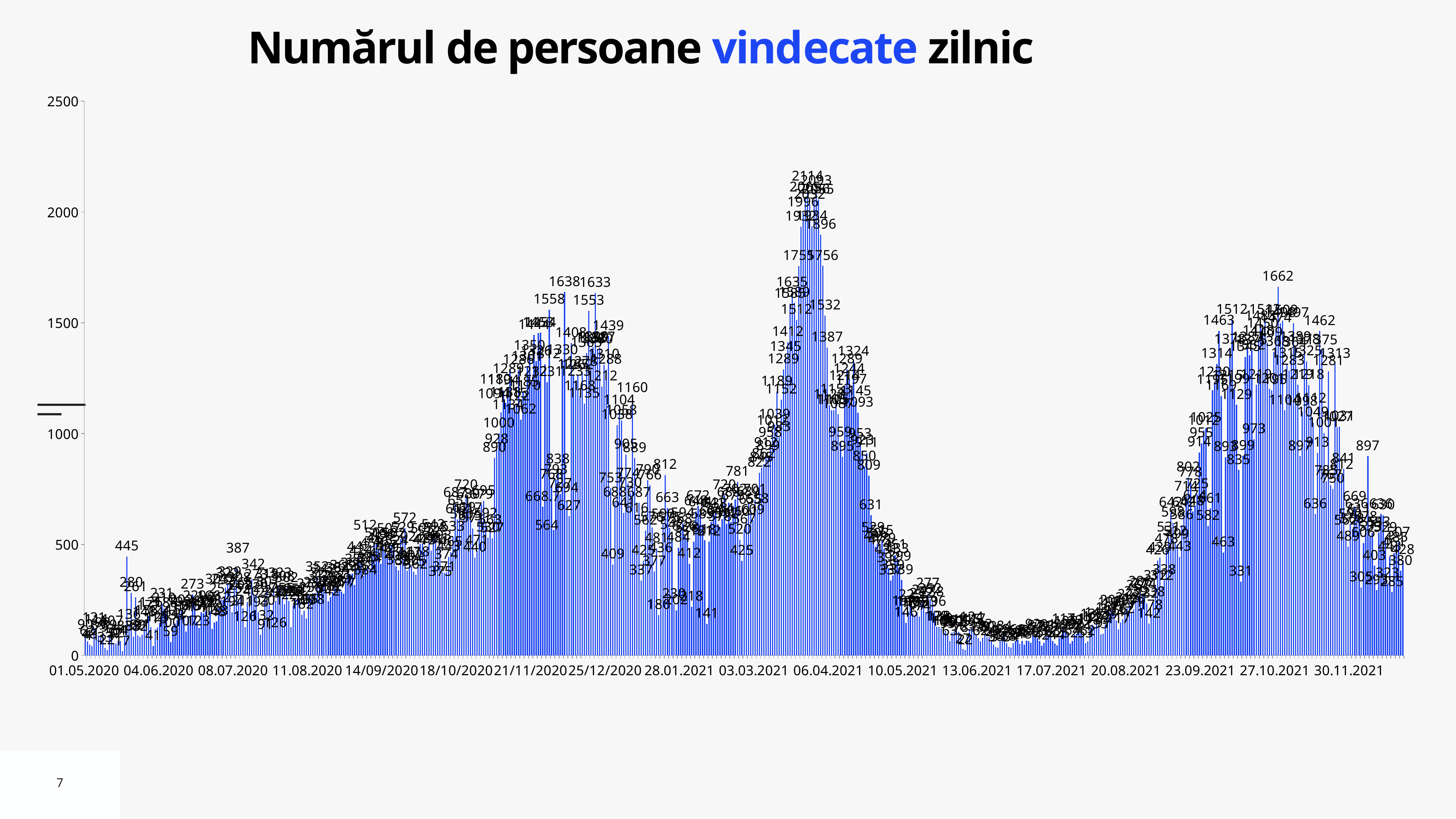
Do the values rise or fall between 06.04.2021 and 10.05.2021? fall Is the peak value around 06.04.2021 greater or less than 2000? greater What is the title of the chart? Numărul de persoane vindecate zilnic Do the values rise or fall between 20.08.2021 and 27.10.2021? rise What is the difference between the highest label of the April 2021 peak (2114) and the highest label of the October 2021 peak (1662)? 452 Which peak is higher: the one around 06.04.2021 or the one around 27.10.2021? 06.04.2021 Are the values around 17.07.2021 greater or less than 500? less How many date labels are shown on the horizontal axis? 18 What is the highest data label shown on the chart? 2114 What is the highest value labeled in the wave around 27.10.2021? 1662 What is the highest value shown on the vertical axis? 2500 What kind of chart is shown on the slide? bar chart